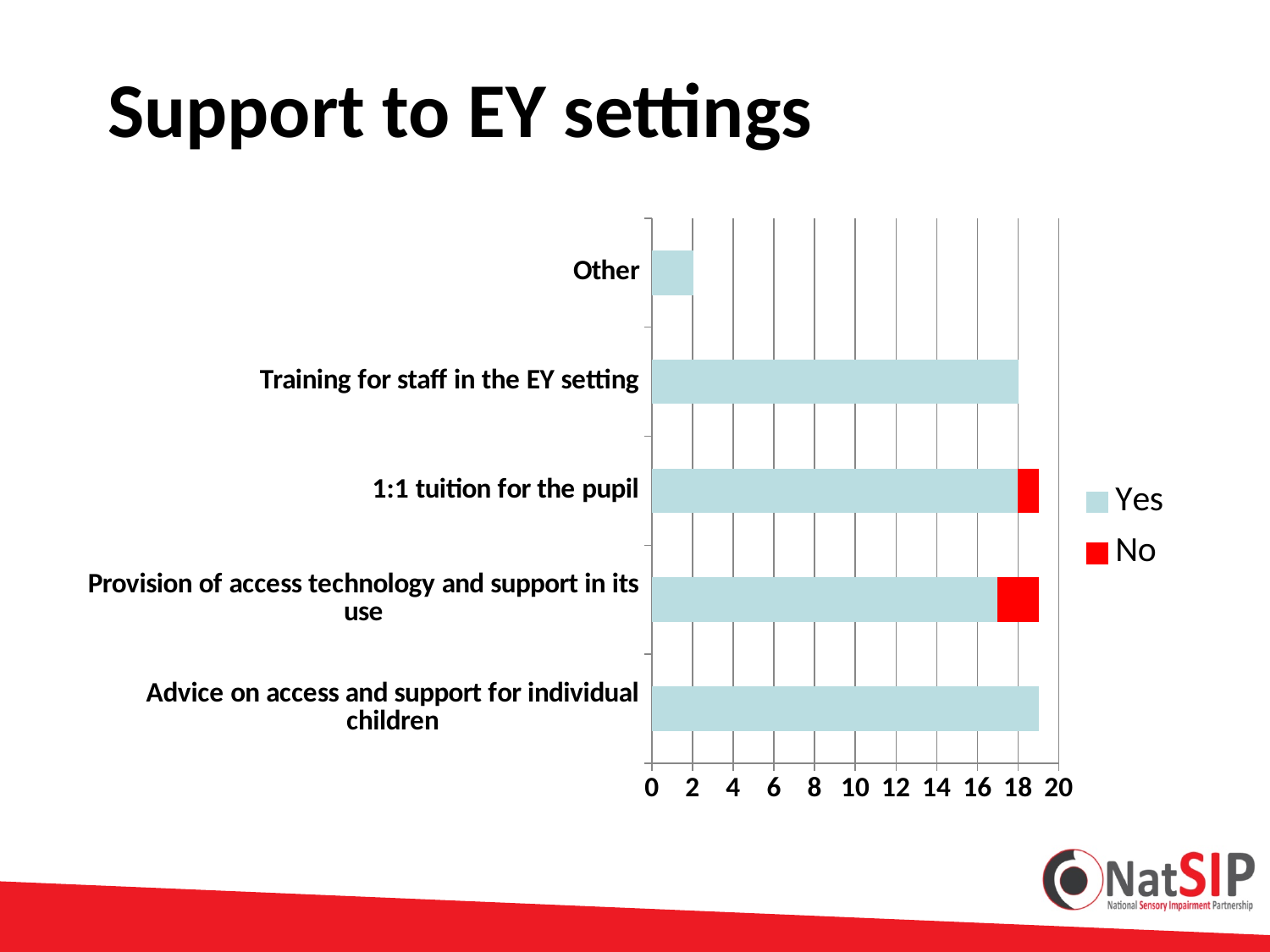
What is the Yes value for Other? 2 Is the Yes value for Provision of access technology and support in its use greater or less than 18? less Which has the larger Yes value, Training for staff in the EY setting or Other? Training for staff in the EY setting What is the Yes value for Training for staff in the EY setting? 18 What colour represents the No series? red Is the Yes value for Advice on access and support for individual children greater or less than 18? greater How many series does the legend list? 2 What is the difference between the Yes values for Training for staff in the EY setting and Other? 16 Which category has the lowest Yes value? Other What kind of chart is shown on the slide? bar chart How many categories are plotted on the chart? 5 What is the Yes value for 1:1 tuition for the pupil? 18